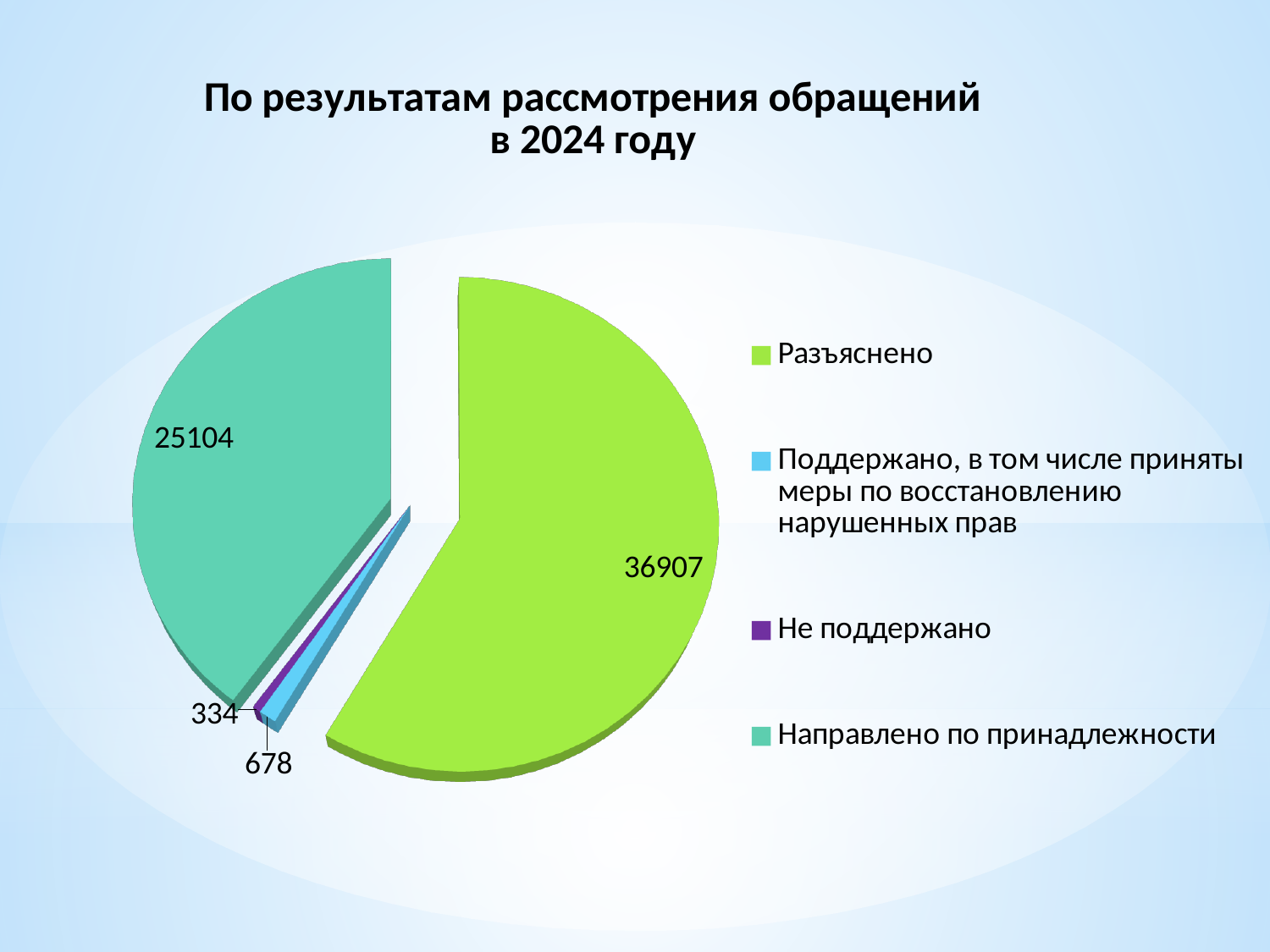
What is the value for Разъяснено? 36907 What type of chart is shown on the slide? pie chart Which is larger: Направлено по принадлежности or Поддержано? Направлено по принадлежности What is the value for Поддержано, в том числе приняты меры по восстановлению нарушенных прав? 678 What is the title of the chart? По результатам рассмотрения обращений в 2024 году What is the difference between the values for Поддержано and Не поддержано? 344 What is the value for Направлено по принадлежности? 25104 What is the difference between the values for Разъяснено and Направлено по принадлежности? 11803 How many categories does the pie chart have? 4 What is the value for Не поддержано? 334 Which category has the smallest slice of the pie? Не поддержано Which category has the largest slice of the pie? Разъяснено